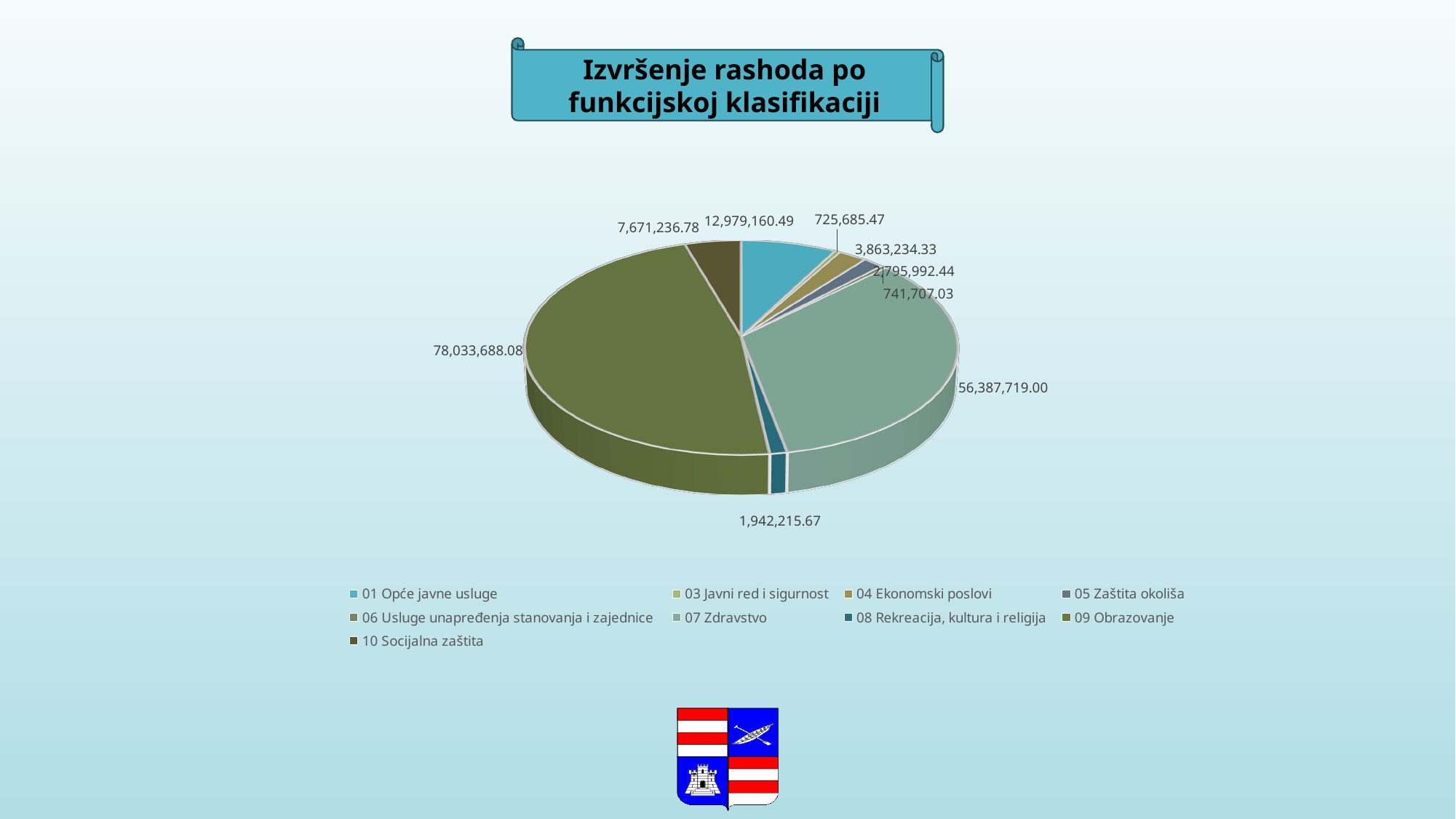
Which category has the smallest value? 03 Javni red i sigurnost How many categories does the legend list? 9 Which category has the largest slice? 09 Obrazovanje What is the value for 01 Opće javne usluge? 12,979,160.49 What is the difference between the values for 01 Opće javne usluge and 10 Socijalna zaštita? 5,307,923.71 What is the value for 09 Obrazovanje? 78,033,688.08 What is the title of the chart? Izvršenje rashoda po funkcijskoj klasifikaciji What kind of chart is shown on the slide? pie chart What is the value for 10 Socijalna zaštita? 7,671,236.78 What is the difference between the values for 09 Obrazovanje and 07 Zdravstvo? 21,645,969.08 Which is larger, the value for 04 Ekonomski poslovi or 05 Zaštita okoliša? 04 Ekonomski poslovi What is the value for 07 Zdravstvo? 56,387,719.00